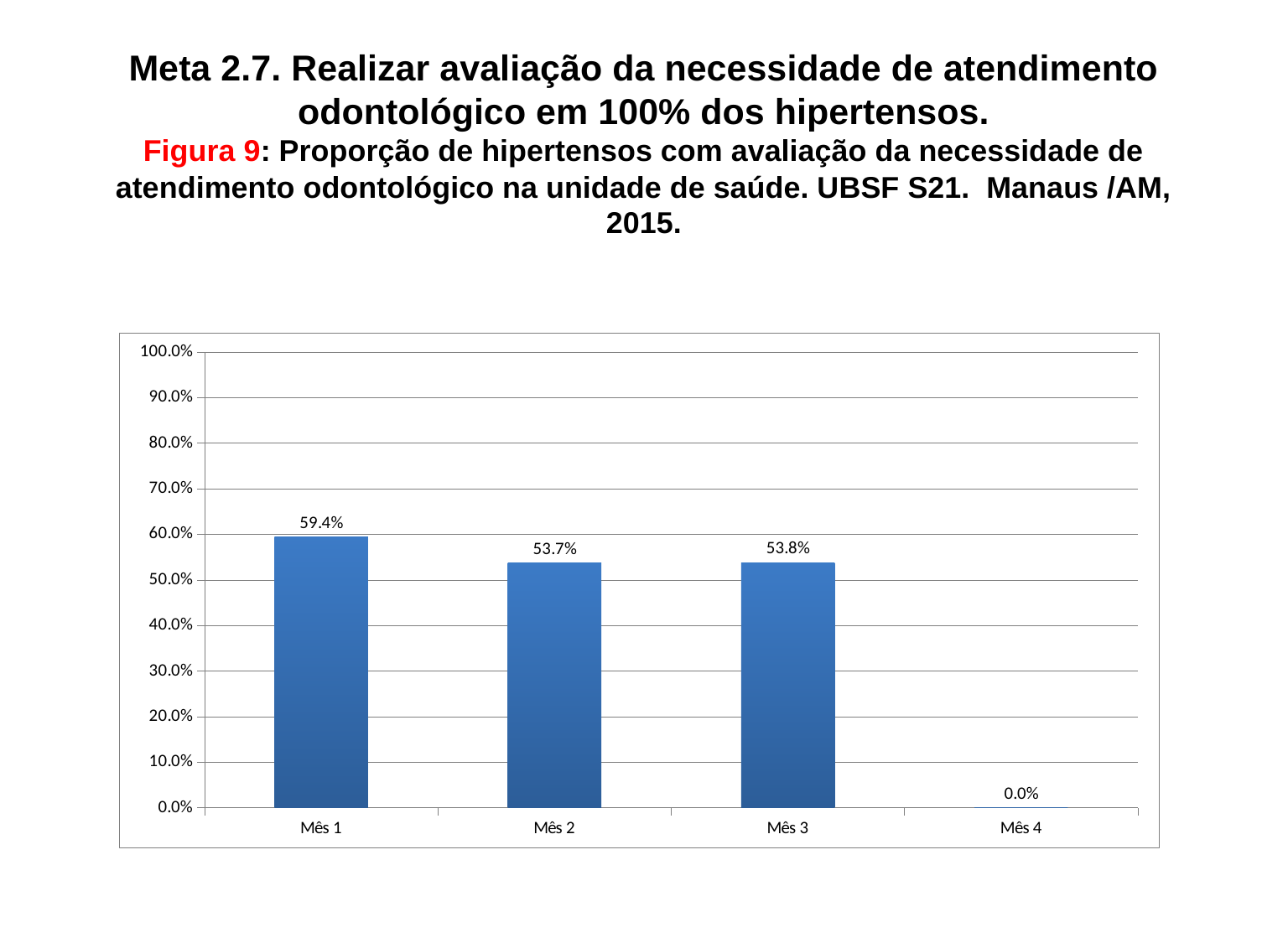
What is the difference between the values for Mês 1 and Mês 2? 5.7% What kind of chart is shown on the slide? bar chart What is the value for Mês 3? 53.8% Which month has the highest value? Mês 1 How many months are shown on the x axis? 4 Is the value for Mês 2 greater or less than 60.0%? less Which month has the lowest value? Mês 4 What is the value for Mês 1? 59.4% What is the value for Mês 2? 53.7% What is the value for Mês 4? 0.0% Which is larger, the value for Mês 1 or the value for Mês 3? Mês 1 What is the figure number given in the slide title? Figura 9